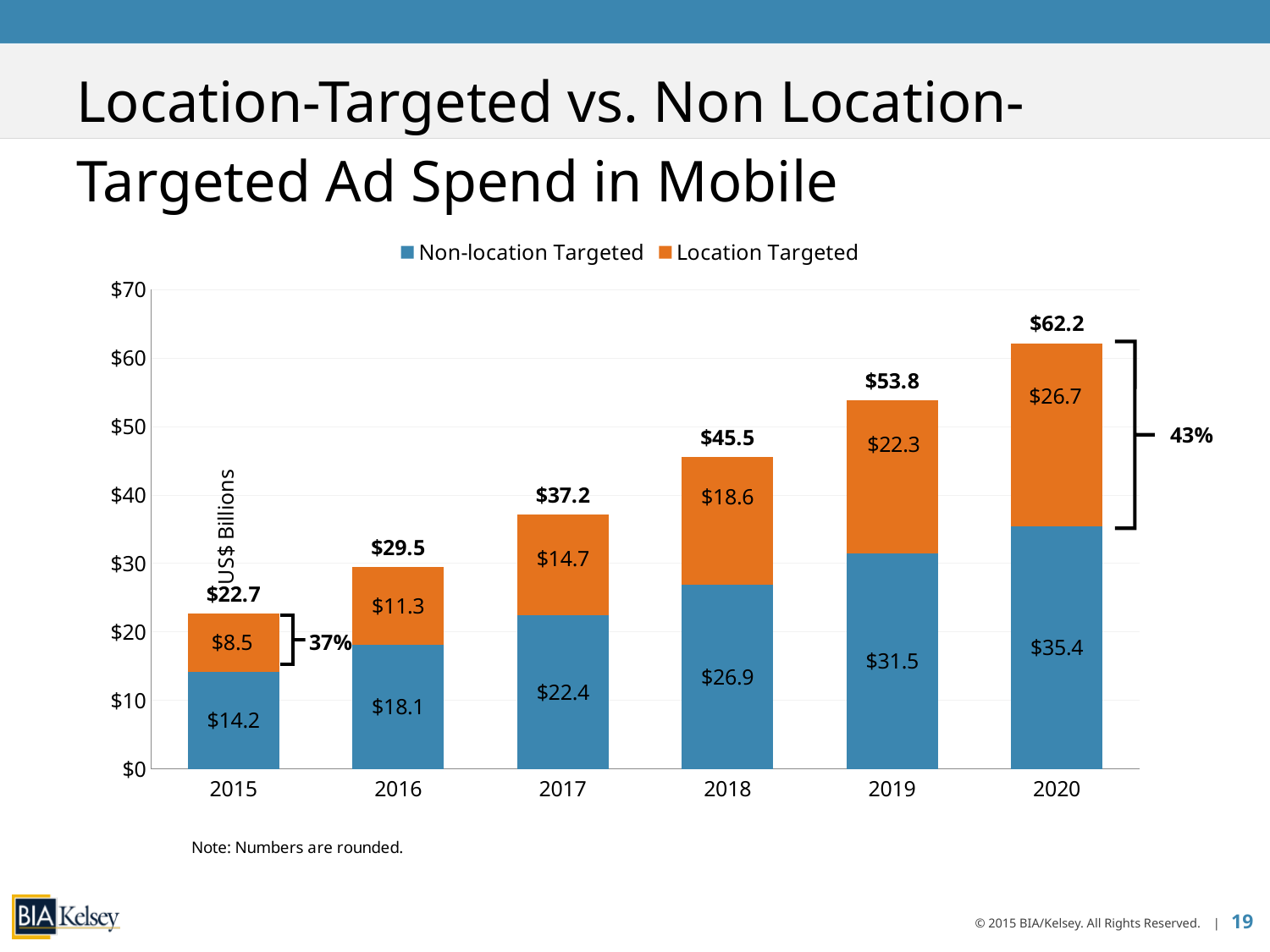
What is the difference between the Non-location Targeted values for 2020 and 2015? $21.2 How many years are shown on the x axis? 6 What is the Non-location Targeted value for 2017? $22.4 Which year has the highest total ad spend? 2020 What is the total ad spend shown for 2020? $62.2 What is the Location Targeted value for 2019? $22.3 Which is larger, the Location Targeted value for 2018 or the Non-location Targeted value for 2016? Location Targeted value for 2018 Which year has the lowest Location Targeted value? 2015 Is the total for 2018 greater or less than $40? greater Do the total values rise or fall from 2015 to 2020? Rise How many series does the legend list? 2 What kind of chart is shown on the slide? Stacked bar chart